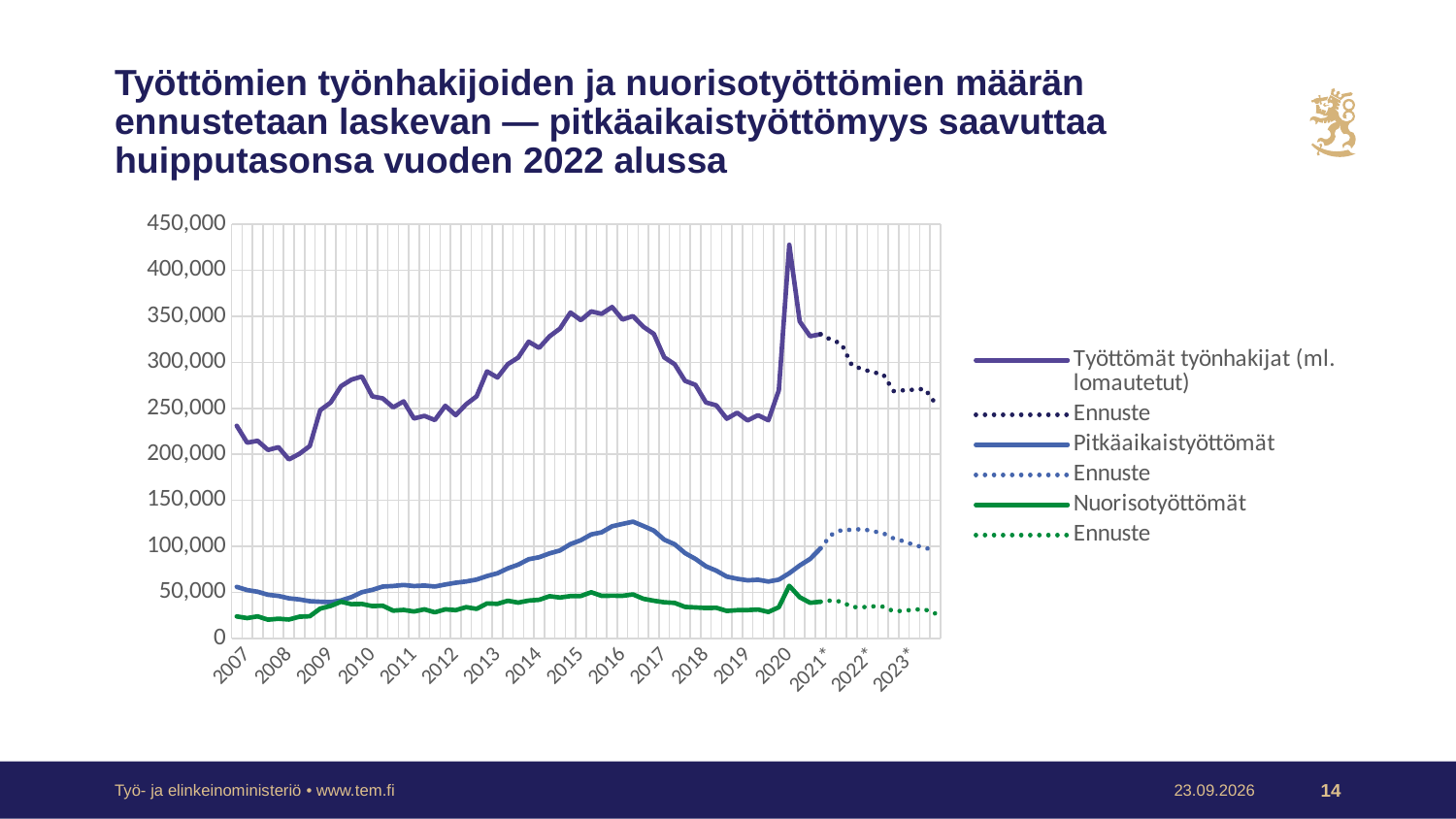
Is the value of Pitkäaikaistyöttömät in 2007 greater or less than 100,000? less How are the Ennuste (forecast) series drawn on the chart compared with the actual series? as dotted lines Which series reaches the highest value on the chart? Työttömät työnhakijat (ml. lomautetut) Is the peak value of Työttömät työnhakijat (ml. lomautetut) in 2020 greater or less than 400,000? greater Is the value of Pitkäaikaistyöttömät in 2016 greater or less than 100,000? greater How many year labels are shown on the x axis of the chart? 17 What colour is the Nuorisotyöttömät line on the chart? green In 2016, which is larger: Pitkäaikaistyöttömät or Nuorisotyöttömät? Pitkäaikaistyöttömät Does the forecast (Ennuste) for Työttömät työnhakijat (ml. lomautetut) rise or fall from 2021* to 2023*? fall How many entries does the chart legend list? 6 What kind of chart is shown on the slide? line chart